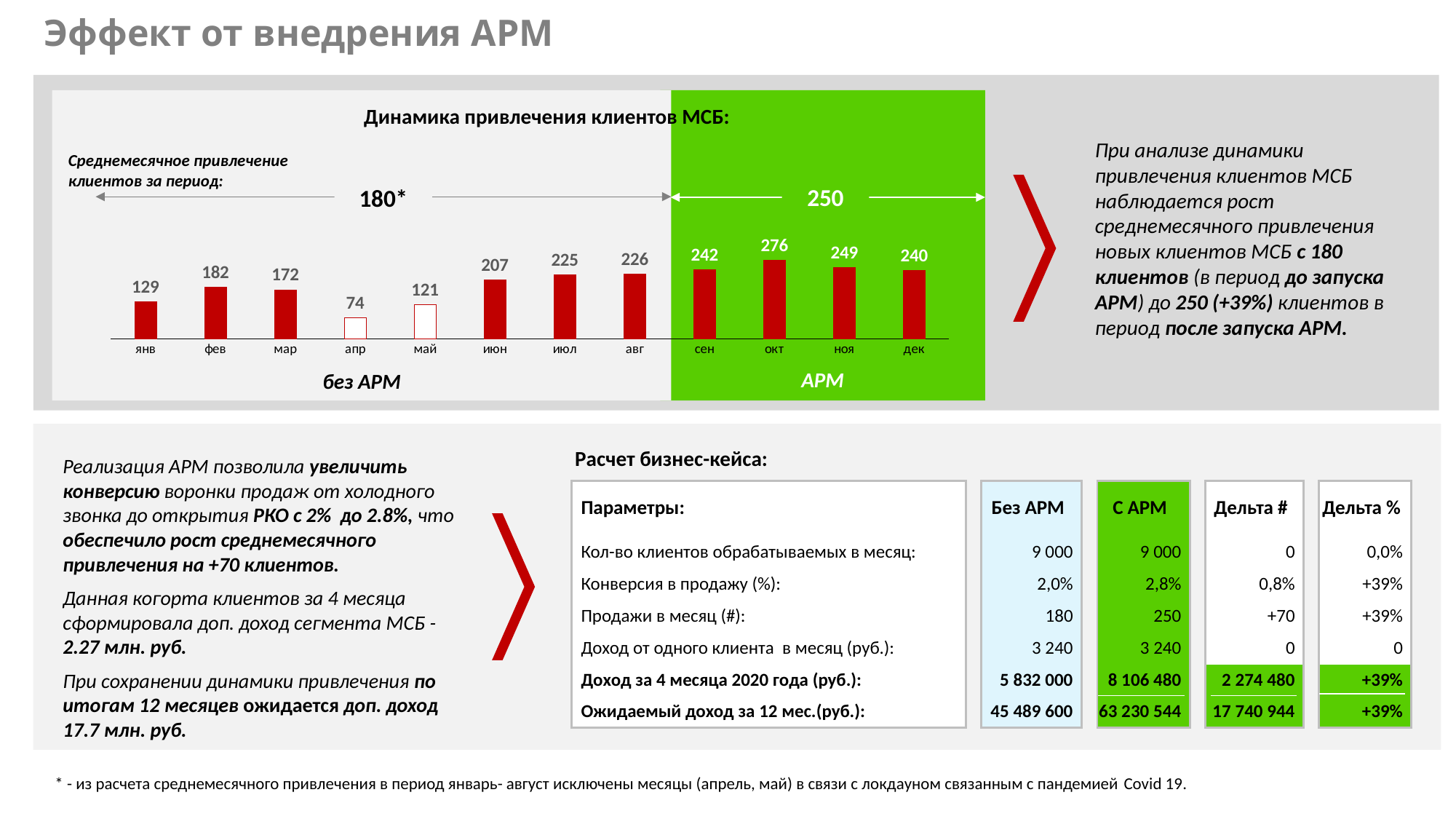
What kind of chart is 'Динамика привлечения клиентов МСБ'? bar chart In the chart 'Динамика привлечения клиентов МСБ', what is the average monthly value shown for the period 'без АРМ'? 180* How many months are shown on the x axis of the chart 'Динамика привлечения клиентов МСБ'? 12 What is the value for апр in the chart 'Динамика привлечения клиентов МСБ'? 74 What is the value for окт in the chart 'Динамика привлечения клиентов МСБ'? 276 Which is larger in the chart 'Динамика привлечения клиентов МСБ', the value for мар or the value for июн? июн What is the difference between the values for окт and сен in the chart 'Динамика привлечения клиентов МСБ'? 34 What is the difference between the values for фев and янв in the chart 'Динамика привлечения клиентов МСБ'? 53 In the chart 'Динамика привлечения клиентов МСБ', what is the average monthly value shown for the period 'АРМ'? 250 Which month has the highest value in the chart 'Динамика привлечения клиентов МСБ'? окт What is the value for янв in the chart 'Динамика привлечения клиентов МСБ'? 129 Which month has the lowest value in the chart 'Динамика привлечения клиентов МСБ'? апр